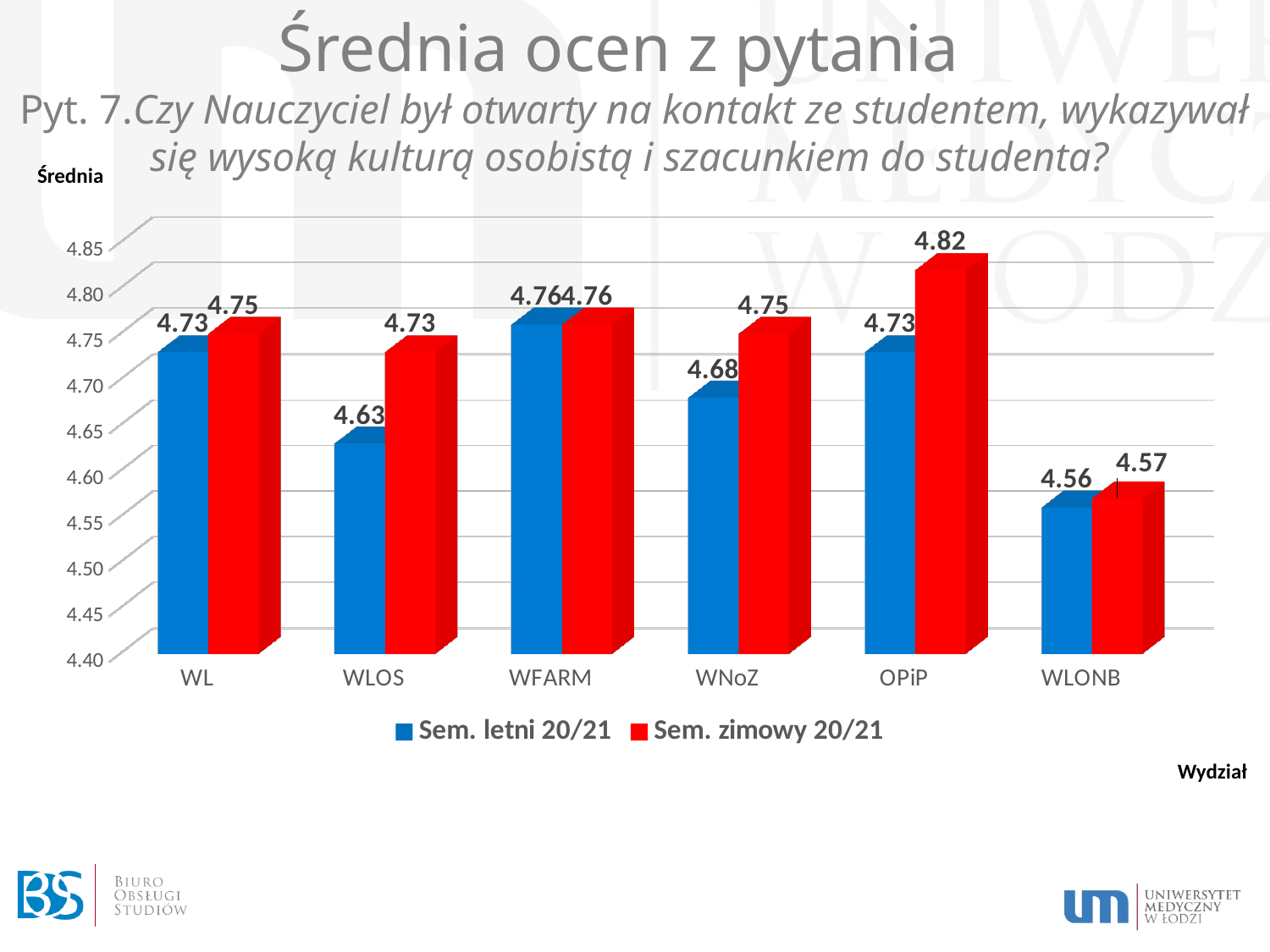
What kind of chart is shown on the slide? Bar chart What is the value for WNoZ in the Sem. letni 20/21 series? 4.68 What is the value for OPiP in the Sem. zimowy 20/21 series? 4.82 What is the difference between the Sem. zimowy 20/21 and Sem. letni 20/21 values for WLOS? 0.10 Which colour represents the Sem. zimowy 20/21 series? Red Which faculty has the lowest value in the Sem. letni 20/21 series? WLONB Which is larger for WNoZ: the Sem. letni 20/21 value or the Sem. zimowy 20/21 value? Sem. zimowy 20/21 Which faculty has the highest value in the Sem. zimowy 20/21 series? OPiP What is the difference between the Sem. zimowy 20/21 and Sem. letni 20/21 values for OPiP? 0.09 What is the value for WLOS in the Sem. letni 20/21 series? 4.63 How many faculties are shown on the x axis? 6 How many series does the legend list? 2